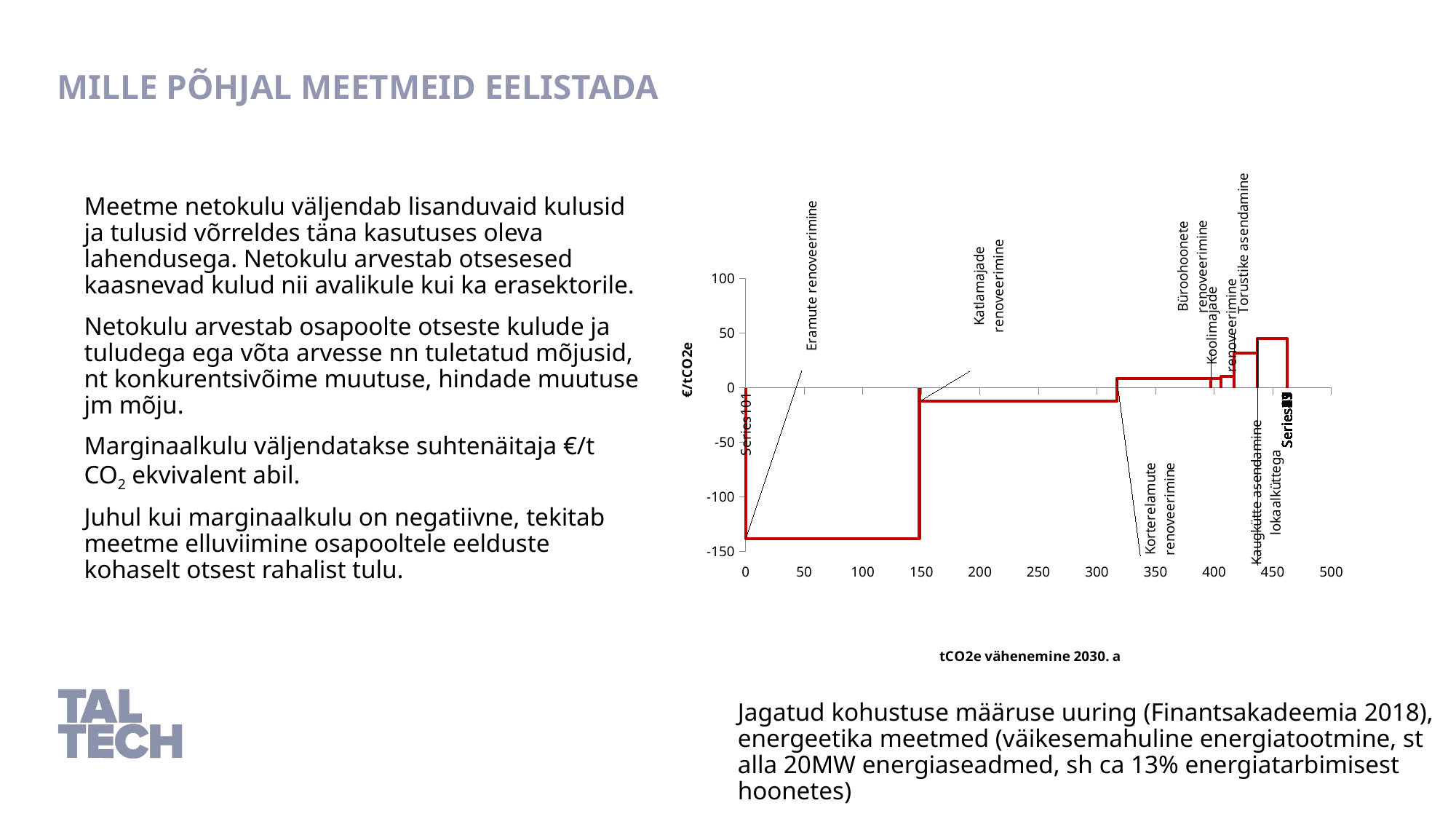
Is the value for Korterelamute renoveerimine greater or less than 50? less Is the value for Katlamajade renoveerimine greater or less than -50? greater Which measure has the lowest marginal cost in €/tCO2e? Eramute renoveerimine What is the label of the horizontal axis of the chart? tCO2e vähenemine 2030. a What kind of chart is shown on the slide? line chart Is the value for Kaugkütte asendamine lokaalküttega greater or less than 0? greater Which measure has the highest marginal cost in €/tCO2e? Kaugkütte asendamine lokaalküttega Do the marginal cost values rise or fall as you move along the x axis from 0 to 500? rise Which has the higher marginal cost, Eramute renoveerimine or Kaugkütte asendamine lokaalküttega? Kaugkütte asendamine lokaalküttega What is the label of the vertical axis of the chart? €/tCO2e